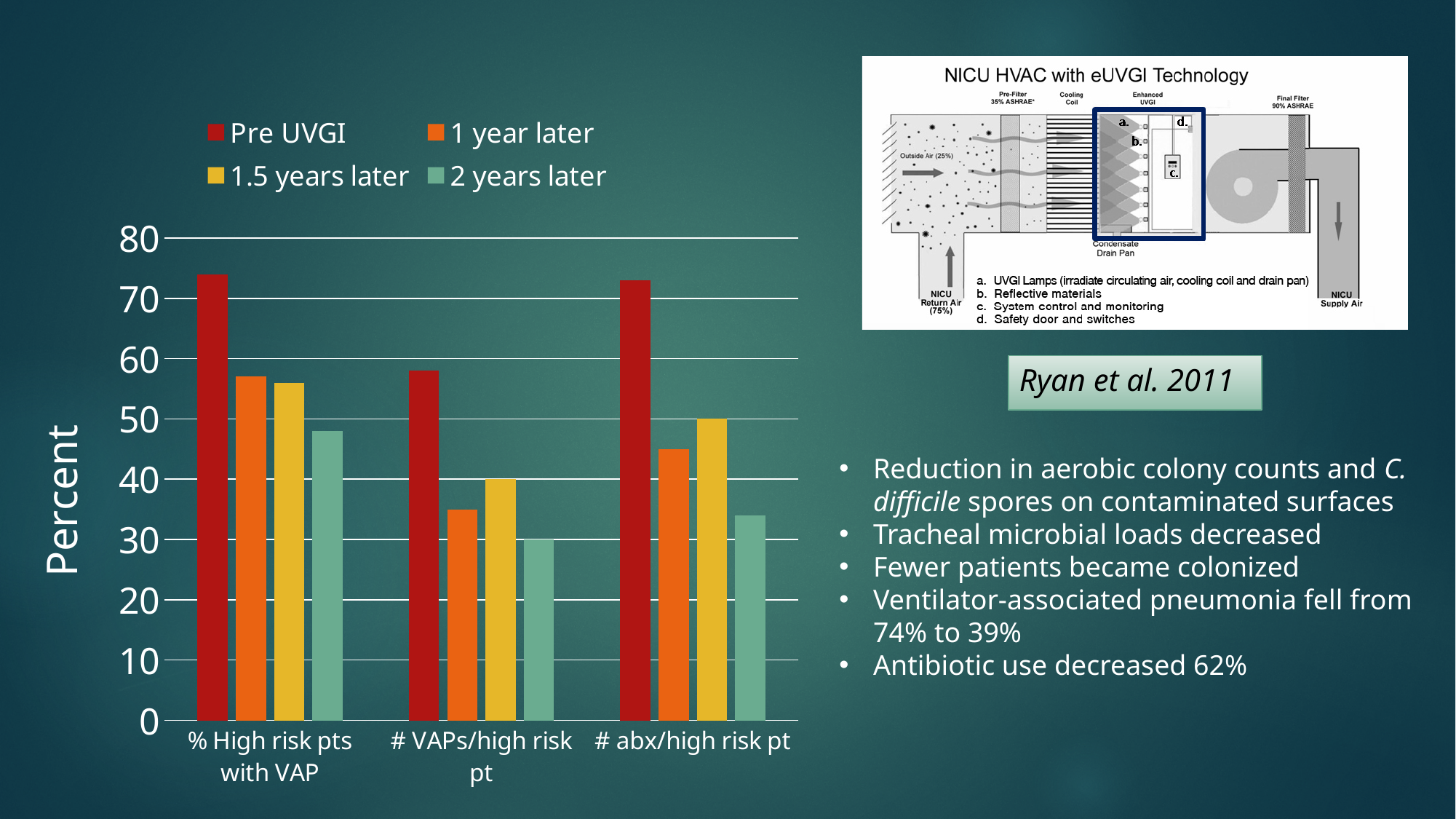
Is the 'Pre UVGI' value for '% High risk pts with VAP' greater or less than 70? greater What kind of chart is shown on the slide? bar chart For '# VAPs/high risk pt', what is the value for '1.5 years later'? 40 How many series does the chart legend list? 4 How many categories are shown on the x axis of the chart? 3 Which series has the highest value for '% High risk pts with VAP'? Pre UVGI Which series is shown in red in the chart legend? Pre UVGI What is the label of the y axis of the chart? Percent For '# abx/high risk pt', what is the value for '1.5 years later'? 50 Which series has the lowest value for '# abx/high risk pt'? 2 years later For '# VAPs/high risk pt', what is the value for '2 years later'? 30 Which is larger for '# VAPs/high risk pt': the 'Pre UVGI' value or the '1 year later' value? Pre UVGI